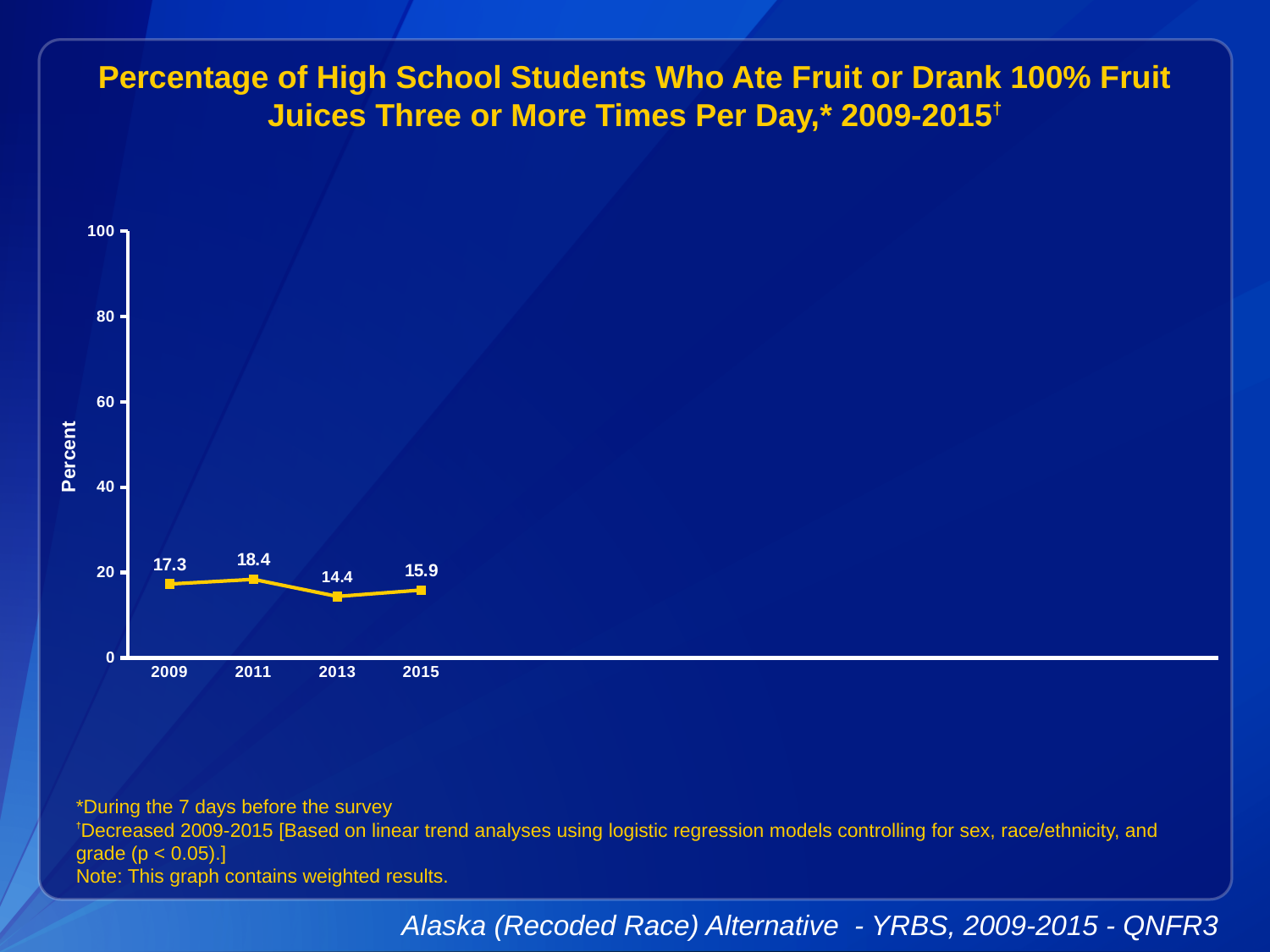
Which year has the lowest value on the chart? 2013 What is the label on the vertical axis? Percent What is the difference between the 2011 value and the 2013 value? 4.0 How many years are plotted on the chart? 4 What is the value plotted for 2015? 15.9 What is the value plotted for 2013? 14.4 What percentage of high school students ate fruit or drank 100% fruit juices three or more times per day in 2009? 17.3 Which year has the highest value on the chart? 2011 Is the value for 2011 greater or less than 20? less Which is larger, the value for 2009 or the value for 2015? 2009 Does the value rise or fall from 2011 to 2013? fall What kind of chart is shown on the slide? line chart